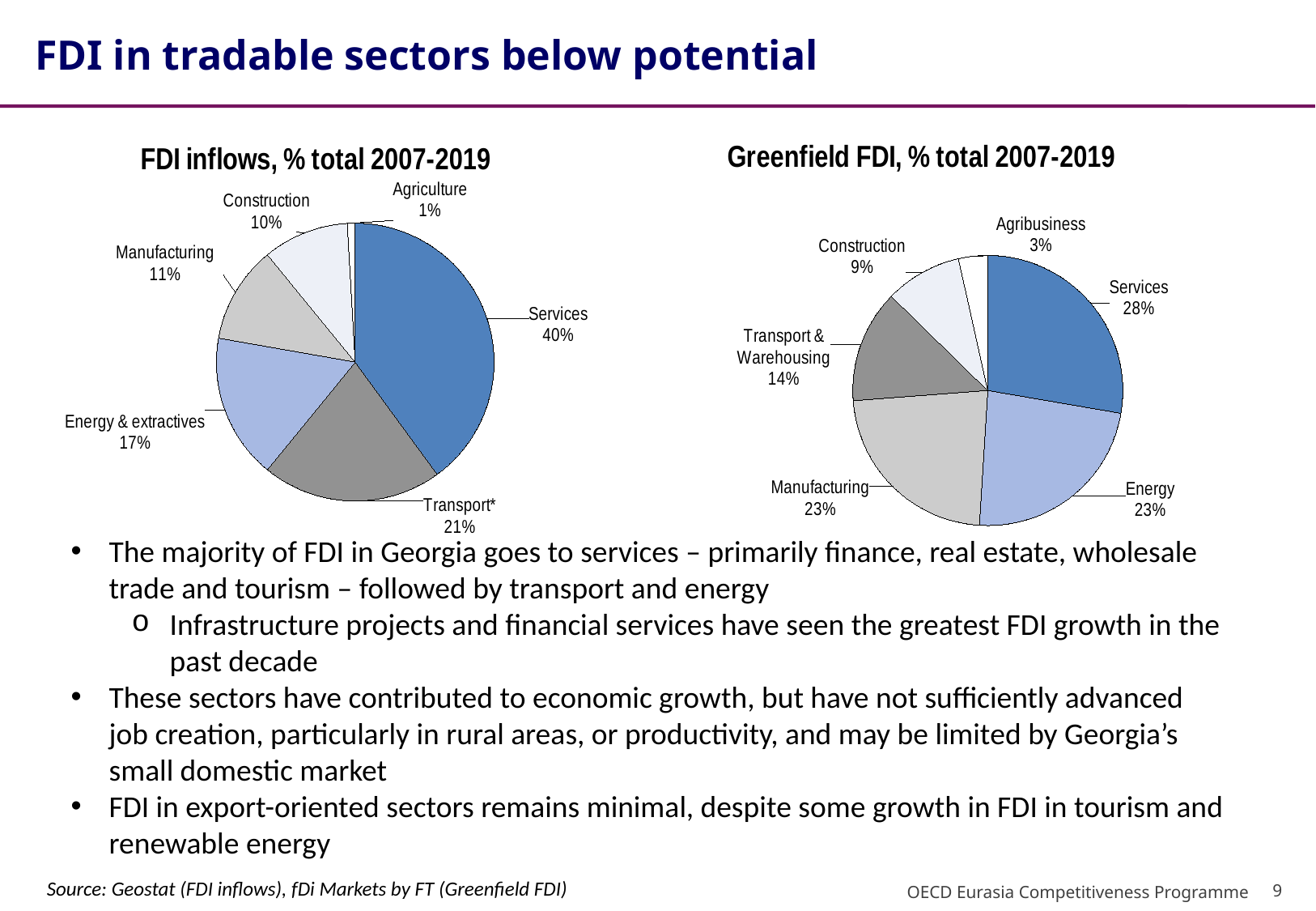
In the 'FDI inflows, % total 2007-2019' chart, what is the difference between the Services share and the Transport* share? 19% In the 'FDI inflows, % total 2007-2019' chart, which sector has the smallest share? Agriculture In the 'Greenfield FDI, % total 2007-2019' chart, what share does Transport & Warehousing have? 14% In the 'Greenfield FDI, % total 2007-2019' chart, what is the difference between the Services share and the Construction share? 19% In the 'Greenfield FDI, % total 2007-2019' chart, what share does Agribusiness have? 3% In the 'FDI inflows, % total 2007-2019' chart, which sector has the largest share? Services In the 'Greenfield FDI, % total 2007-2019' chart, which sector has the largest share? Services In the 'FDI inflows, % total 2007-2019' chart, what share does Energy & extractives have? 17% What type of chart is the 'Greenfield FDI, % total 2007-2019' chart? Pie chart In the 'Greenfield FDI, % total 2007-2019' chart, which is larger, Construction or Transport & Warehousing? Transport & Warehousing In the 'FDI inflows, % total 2007-2019' chart, what share does Services have? 40% In the 'FDI inflows, % total 2007-2019' chart, how many sectors are shown? 6